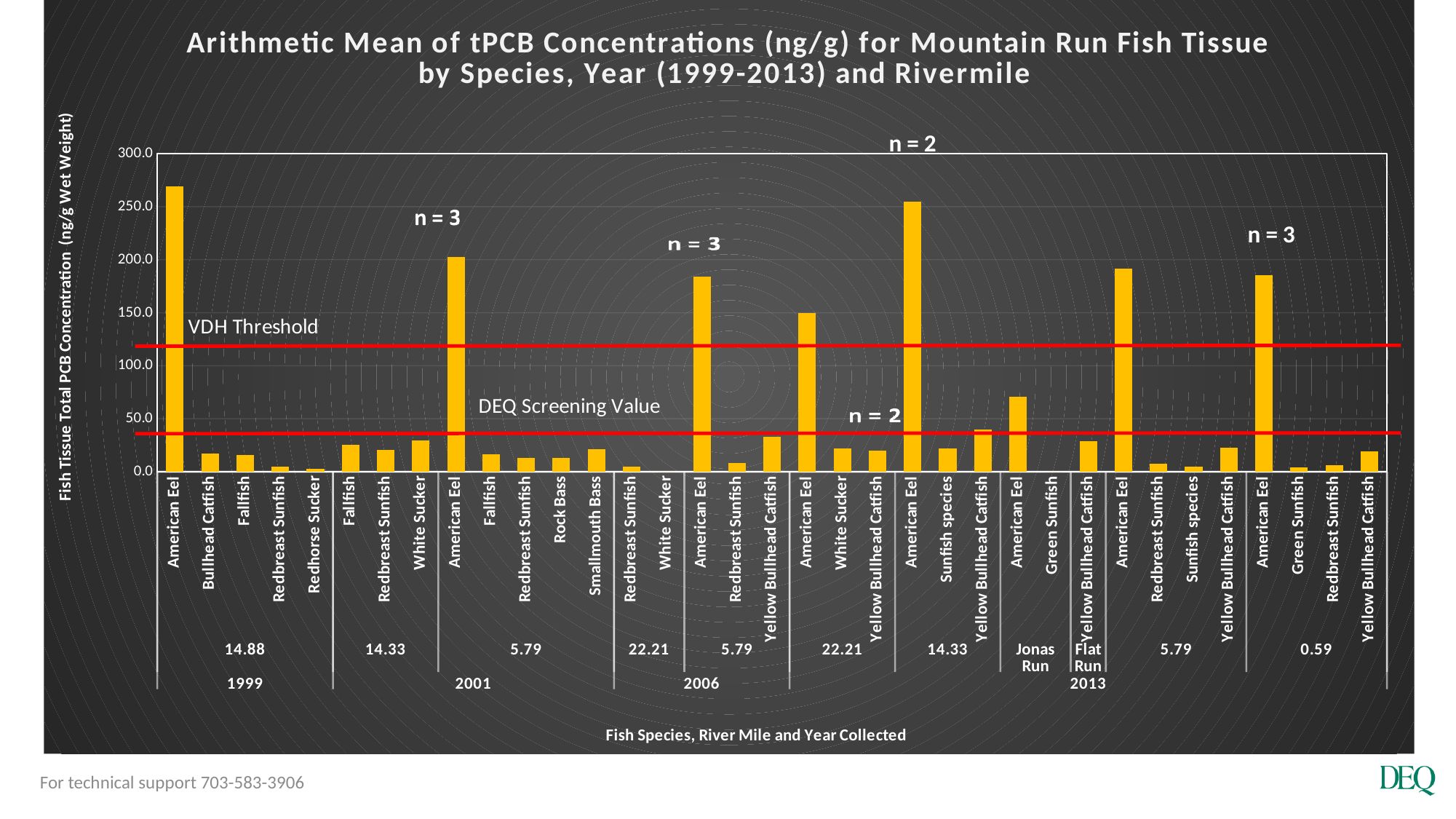
Is the value for American Eel at Jonas Run in 2013 greater or less than 100? less What does the upper red horizontal line represent? VDH Threshold What kind of chart is shown on the slide? bar chart Is the value for Yellow Bullhead Catfish at rivermile 14.33 in 2013 greater or less than 50? less Is the value for American Eel at rivermile 5.79 in 2001 greater or less than 150? greater How many bars are in the 1999 group? 5 Which is larger: the American Eel value at rivermile 14.33 in 2013 or the American Eel value at rivermile 22.21 in 2013? rivermile 14.33 in 2013 Which bar is the highest on the chart? American Eel, rivermile 14.88, 1999 How many year groups are shown along the x axis? 4 Which is larger: the Fallfish value at rivermile 14.33 in 2001 or the Fallfish value at rivermile 5.79 in 2001? rivermile 14.33 in 2001